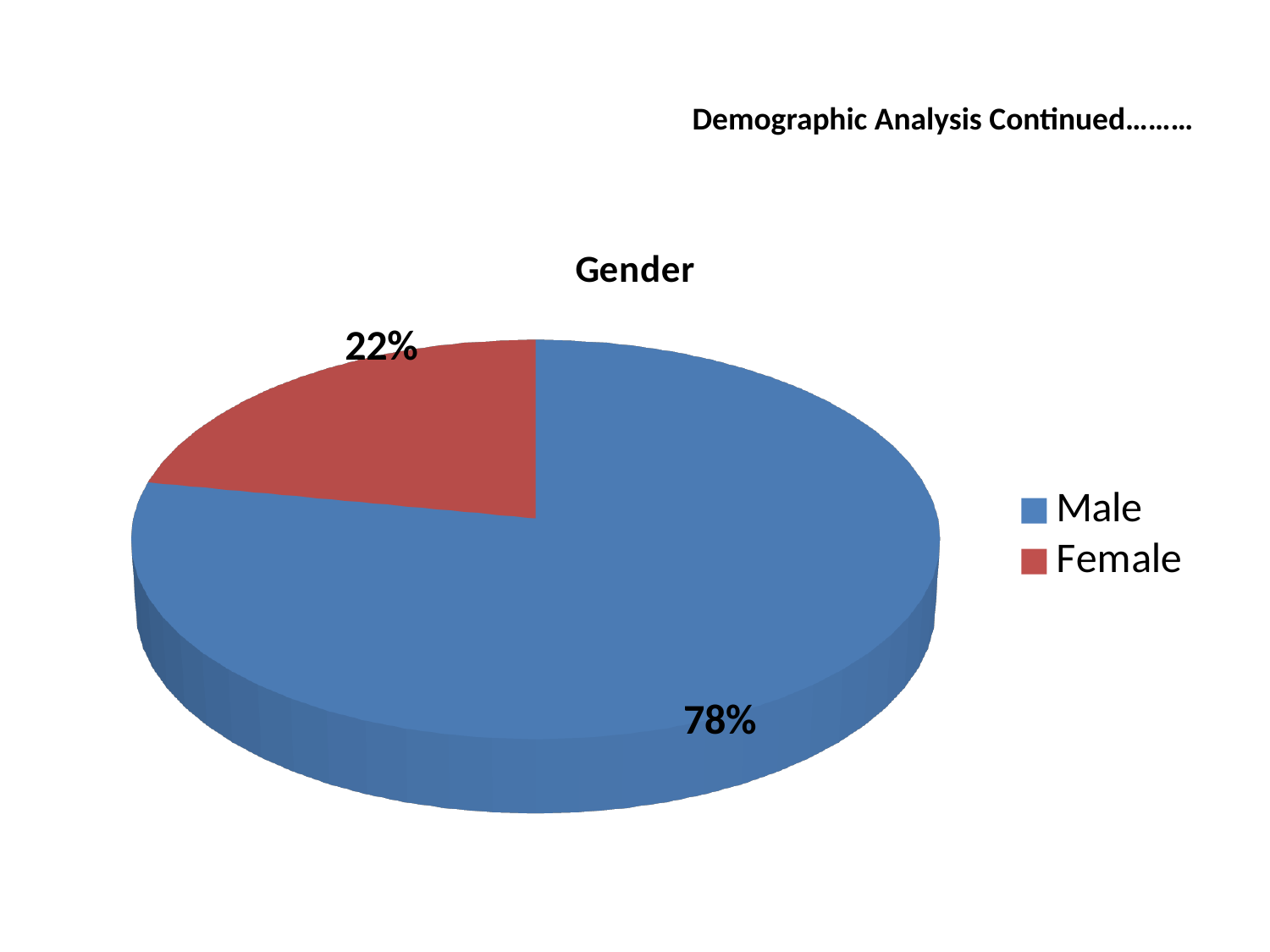
Which category has the smallest share of the pie? Female What is the difference in percentage points between the Male and Female shares? 56 What is the title of the chart? Gender What share of the pie is taken by the blue slice? 78% What percentage of the pie does Female represent? 22% What colour is the Female slice? Red How many entries does the legend list? 2 What percentage of the pie does Male represent? 78% What kind of chart is shown on the slide? Pie chart Which category has the largest share of the pie? Male How many categories are shown in the pie chart? 2 Which is larger, the Male share or the Female share? Male